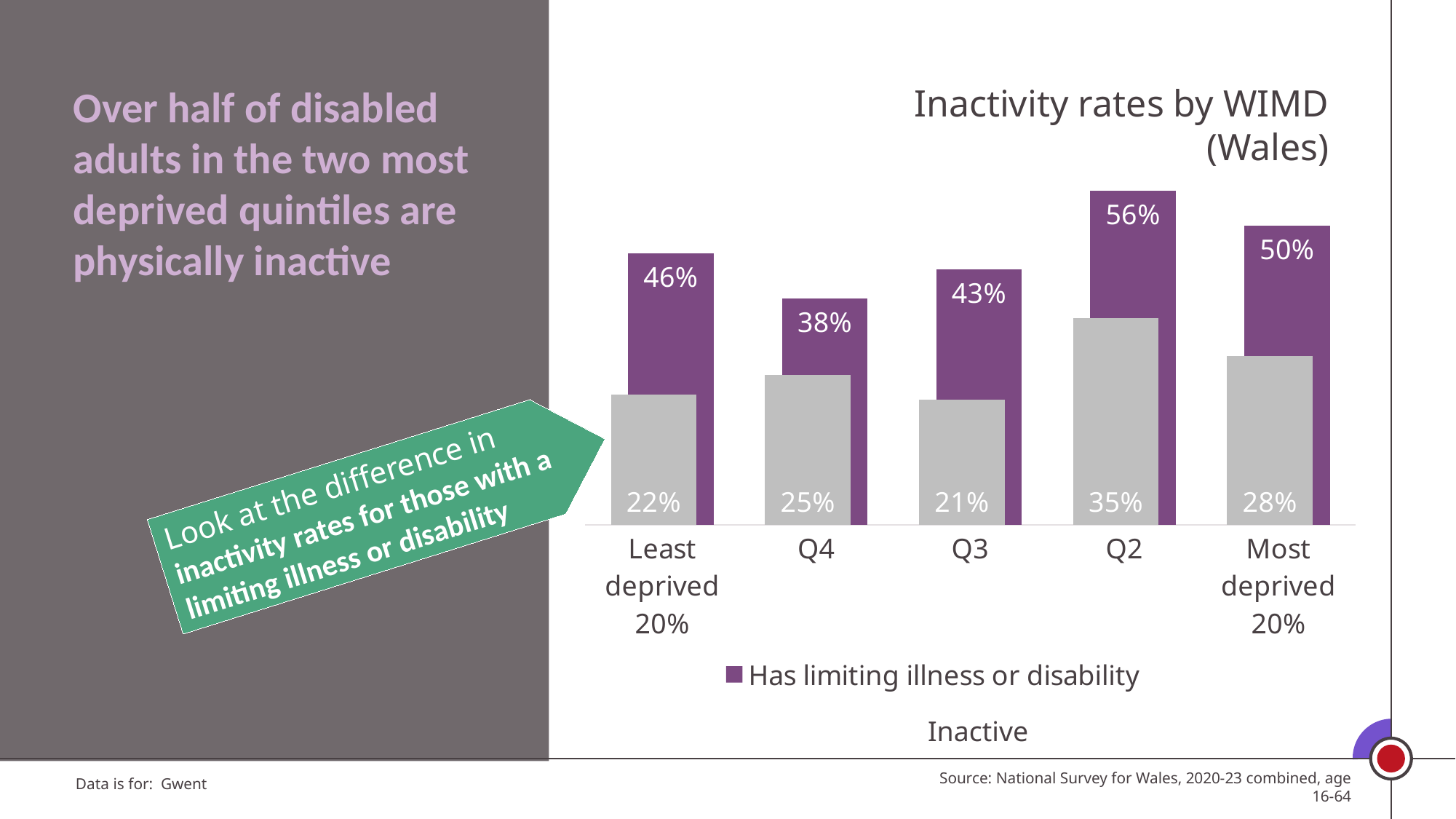
Which is larger: the 'Has limiting illness or disability' value for Q4 or for the Least deprived 20%? Least deprived 20% How many quintile categories are shown on the x axis? 5 What is the difference between the purple and grey bars for Q3? 22% What is the value of the grey bar for the Least deprived 20% quintile? 22% Which quintile has the lowest value among the grey bars? Q3 Which quintile has the highest inactivity rate for those with a limiting illness or disability? Q2 What type of chart is shown on the slide? Bar chart What is the inactivity rate for those with a limiting illness or disability in Q2? 56% What is the inactivity rate for those with a limiting illness or disability in the Most deprived 20% quintile? 50% What is the title of the chart? Inactivity rates by WIMD (Wales) What is the difference between the 'Has limiting illness or disability' values for Q2 and Q4? 18% What colour are the bars for 'Has limiting illness or disability'? Purple